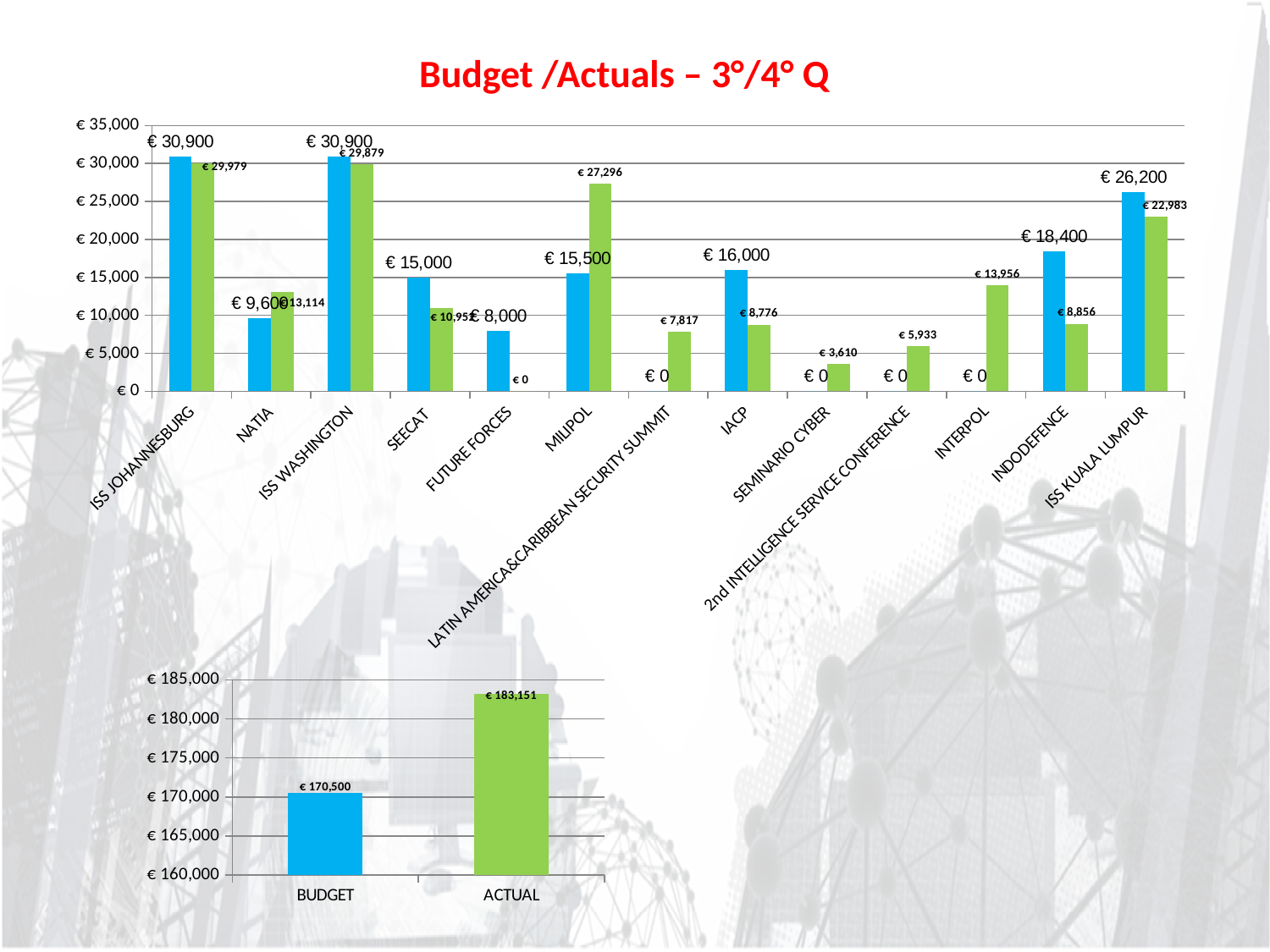
What kind of chart is the bottom chart? bar chart In the bottom chart, what is the difference between ACTUAL and BUDGET? € 12,651 In the top chart, which is larger for NATIA, the blue bar or the green bar? the green bar In the top chart, what is the value of the blue bar for ISS KUALA LUMPUR? € 26,200 What is the title of the slide above the charts? Budget /Actuals – 3°/4° Q In the top chart, what is the value of the blue bar for INDODEFENCE? € 18,400 In the top chart, what is the value of the green bar for INTERPOL? € 13,956 In the top chart, what is the difference between the blue bar and the green bar for IACP? € 7,224 In the top chart, how many categories are shown on the x axis? 13 In the top chart, which category has the highest green bar? ISS JOHANNESBURG In the bottom chart, what is the value for ACTUAL? € 183,151 In the top chart, what is the value of the green bar for MILIPOL? € 27,296